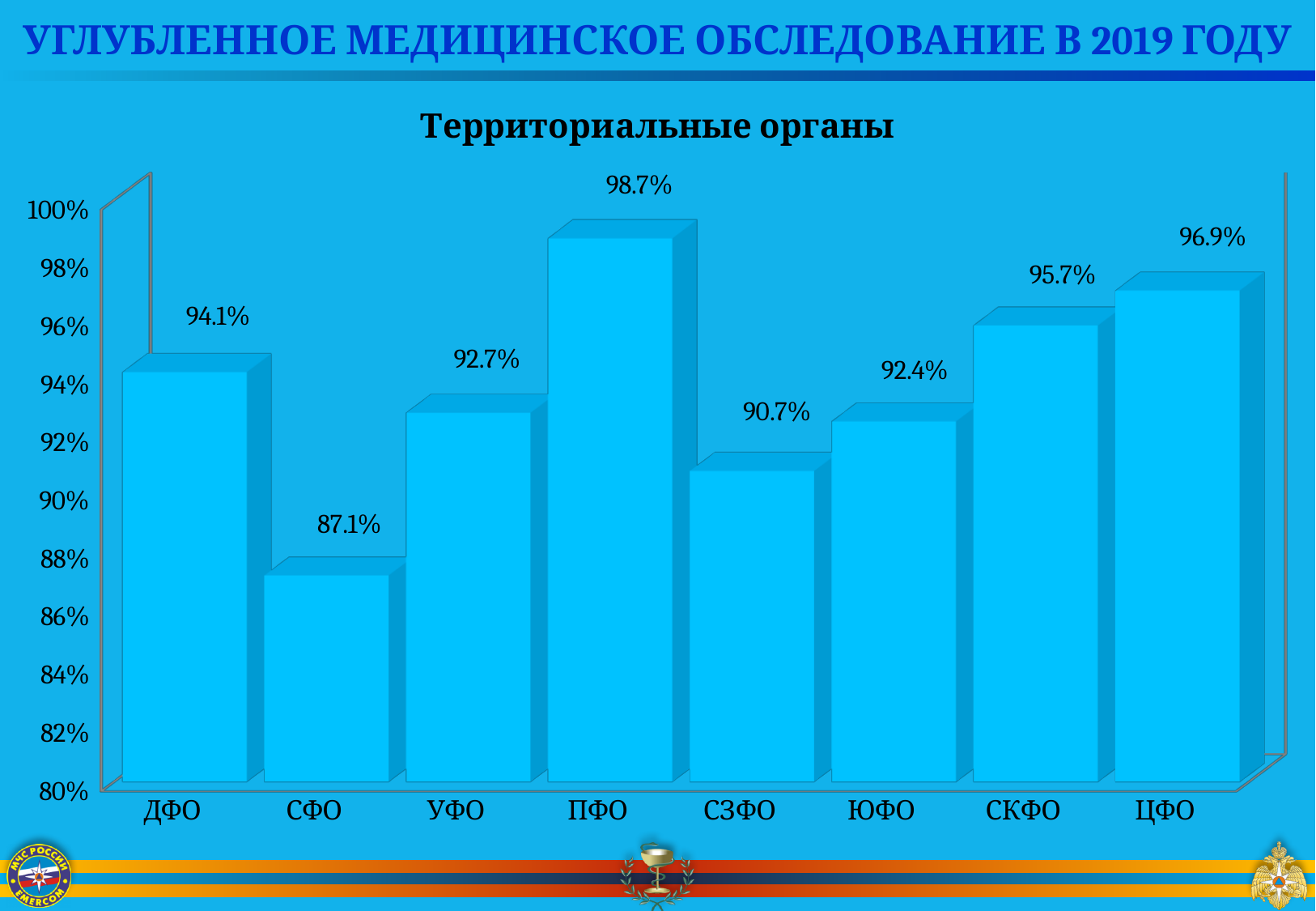
Is the value for СЗФО greater or less than 92%? less What is the value for СФО? 87.1% How many categories are shown on the x axis? 8 Which category has the highest value? ПФО What is the difference between the values for ПФО and СФО? 11.6% Which is larger, the value for ДФО or the value for УФО? ДФО What is the title of the chart? Территориальные органы What kind of chart is shown on the slide? bar chart Which category has the lowest value? СФО What is the difference between the values for ЦФО and СКФО? 1.2% What is the value for ПФО? 98.7% What is the value for СКФО? 95.7%